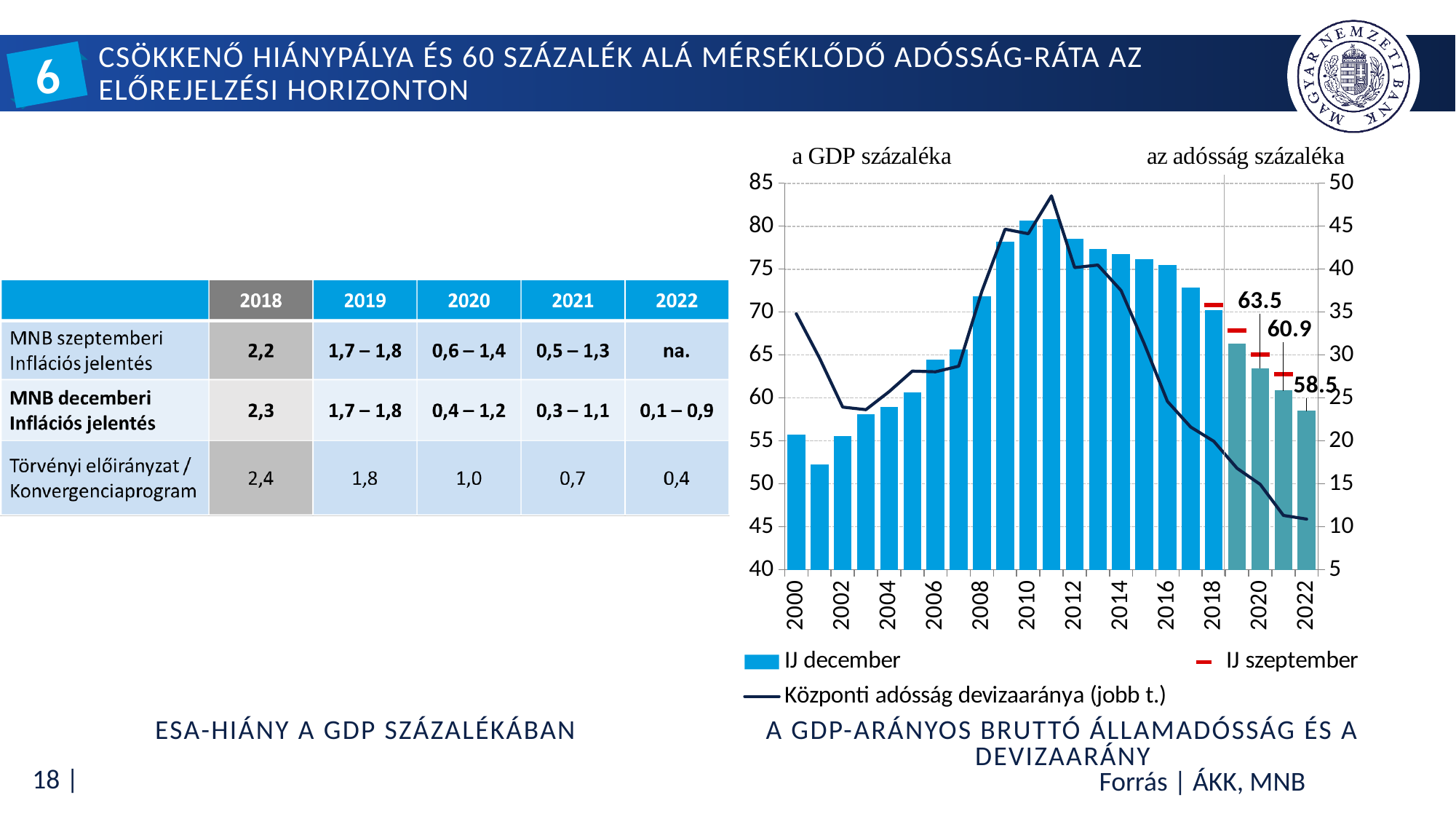
In the right-hand chart, do the IJ december bars rise or fall from 2011 to 2022? fall In the right-hand chart, what is the difference between the labelled values for 2020 and 2022? 5.0 In the chart 'A GDP-arányos bruttó államadósság és a devizaarány', what is the labelled value of the IJ december bar for 2022? 58.5 What kind of chart is shown on the right side of the slide? A combined bar and line chart In the right-hand chart, is the IJ december bar for 2011 greater or less than 80? greater How many series does the legend of the right-hand chart list? 3 In the right-hand chart, which year has the higher labelled value, 2020 or 2022? 2020 In the right-hand chart, which year has the lowest IJ december bar? 2001 In the chart 'A GDP-arányos bruttó államadósság és a devizaarány', what is the labelled value of the IJ december bar for 2021? 60.9 In the right-hand chart, which year has the highest IJ december bar? 2011 In the right-hand chart, is the IJ december bar for 2001 greater or less than 55? less In the chart 'A GDP-arányos bruttó államadósság és a devizaarány', what is the labelled value of the IJ december bar for 2020? 63.5